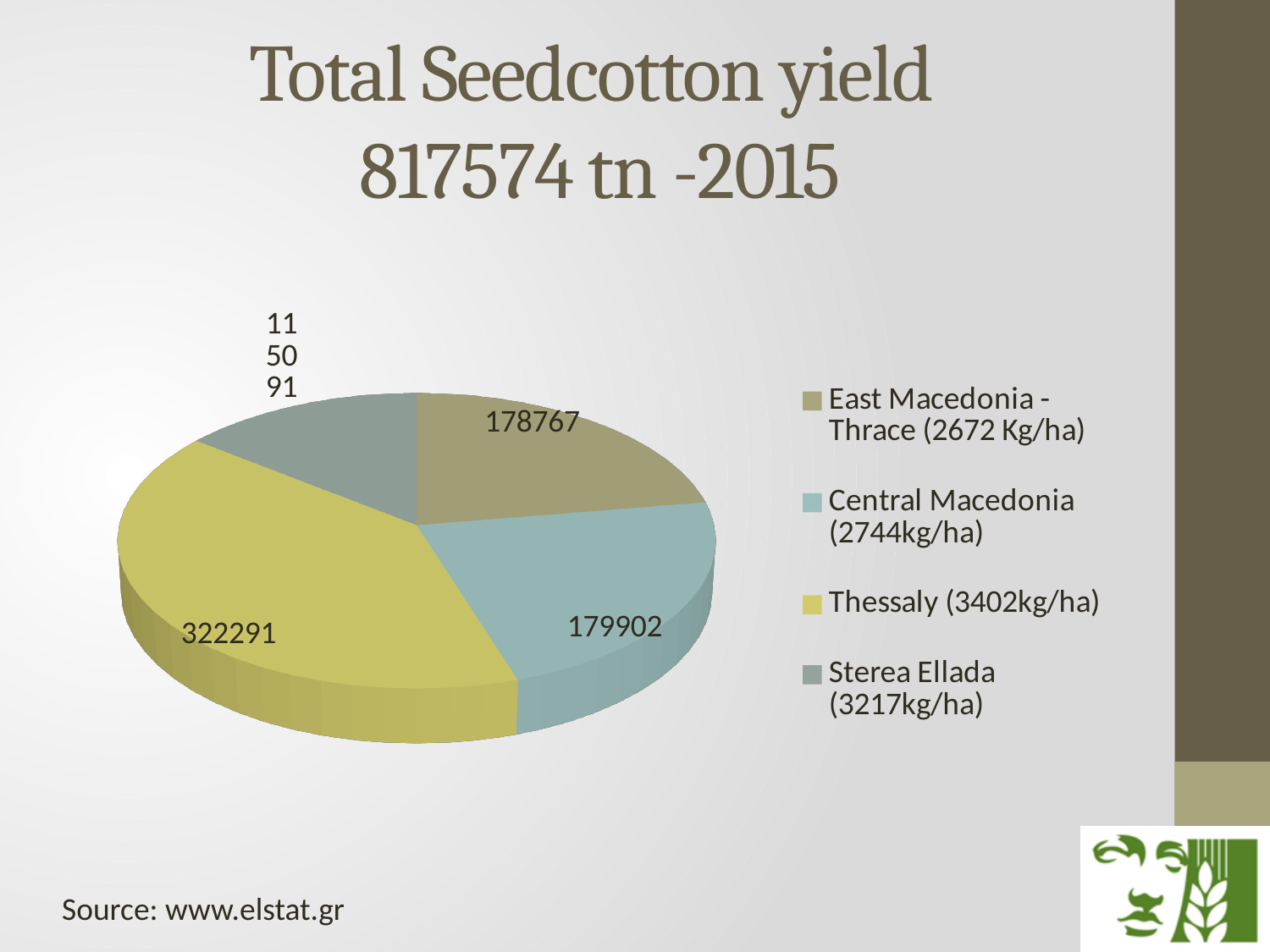
What is the difference between the values for Central Macedonia and East Macedonia - Thrace? 1135 What is the value for Thessaly? 322291 What is the value for Sterea Ellada? 115091 How many regions are shown in the pie chart? 4 What is the value for Central Macedonia? 179902 Which region has the smallest slice of the pie? Sterea Ellada What kind of chart is shown on the slide? Pie chart Which region has the largest slice of the pie? Thessaly Which is larger, the value for Thessaly or the value for Central Macedonia? Thessaly What is the value for East Macedonia - Thrace? 178767 What is the difference between the values for Thessaly and Sterea Ellada? 207200 According to the legend, what is the yield per hectare for Thessaly? 3402kg/ha